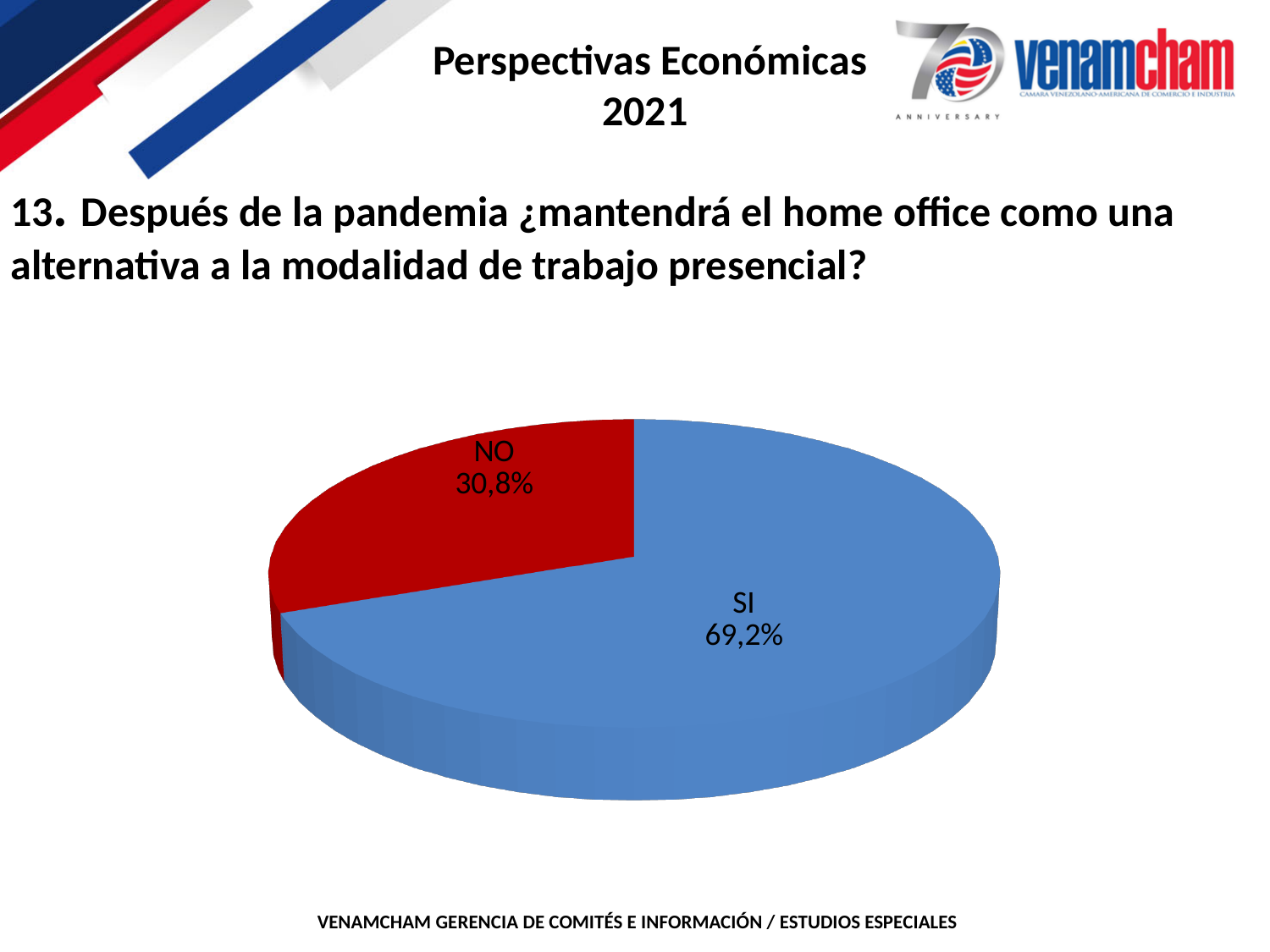
What percentage of respondents answered NO? 30,8% How many slices does the pie chart have? 2 What kind of chart is shown on the slide? Pie chart What percentage of respondents answered SI? 69,2% Which response is larger, SI or NO? SI What colour is the slice for NO? Red What is the difference in percentage points between the SI and NO responses? 38,4 What share of the pie does the SI slice represent? 69,2% What colour is the slice for SI? Blue Which response has the smallest share of the pie? NO Which response has the largest share of the pie? SI